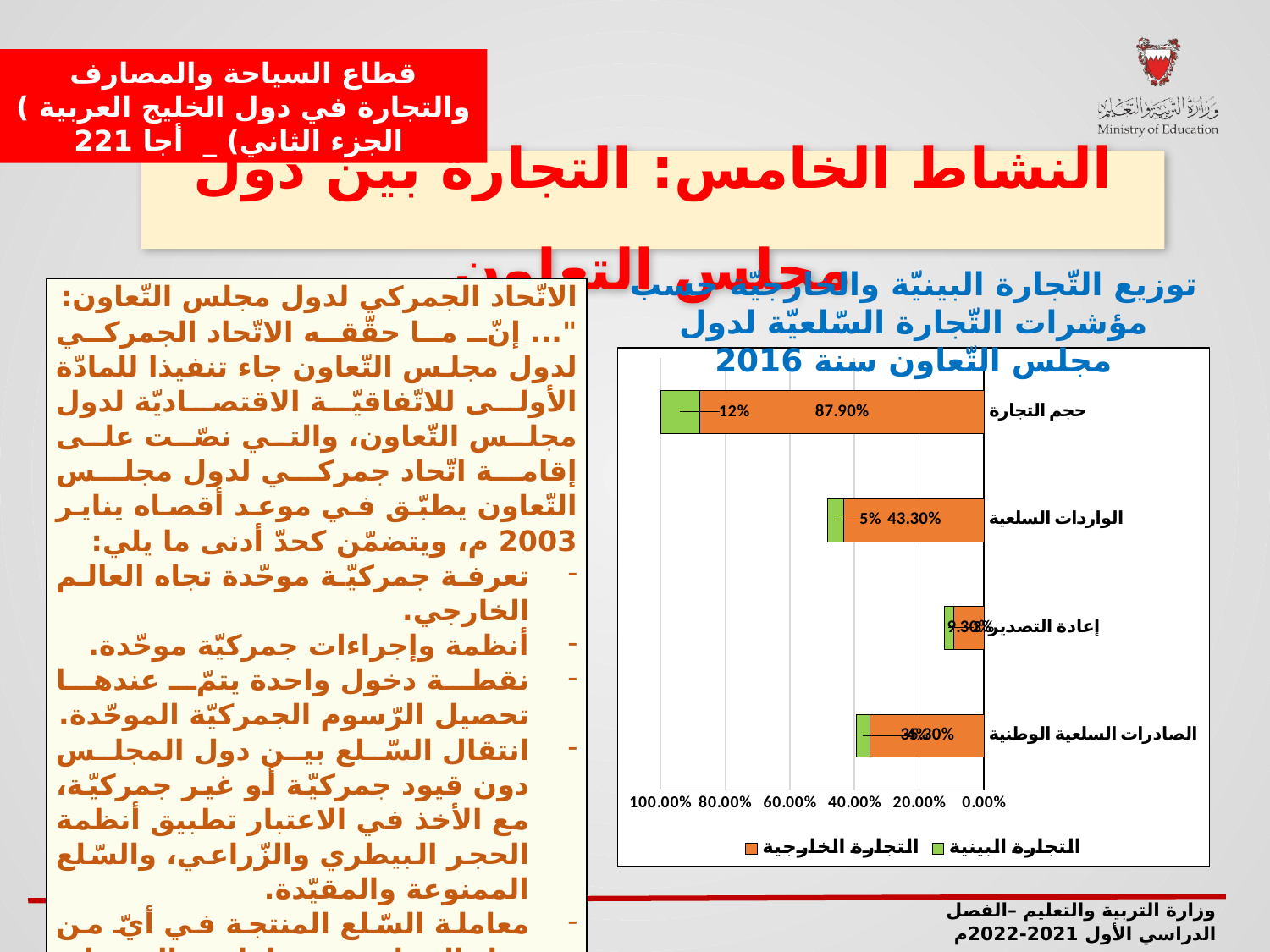
What is the value of التجارة البينية for حجم التجارة? 12% Which category has the lowest value for التجارة الخارجية? إعادة التصدير How many series does the chart legend list? 2 Is the value of التجارة الخارجية for إعادة التصدير greater or less than 20.00%? less Which colour represents التجارة الخارجية in the chart? orange What is the value of التجارة الخارجية for الواردات السلعية? 43.30% What kind of chart is shown on the slide? bar chart What is the value of التجارة الخارجية for حجم التجارة? 87.90% What is the value of التجارة البينية for الواردات السلعية? 5% What is the difference between the التجارة الخارجية values for حجم التجارة and الواردات السلعية? 44.60% How many categories are plotted on the chart? 4 Which category has the highest value for التجارة الخارجية? حجم التجارة